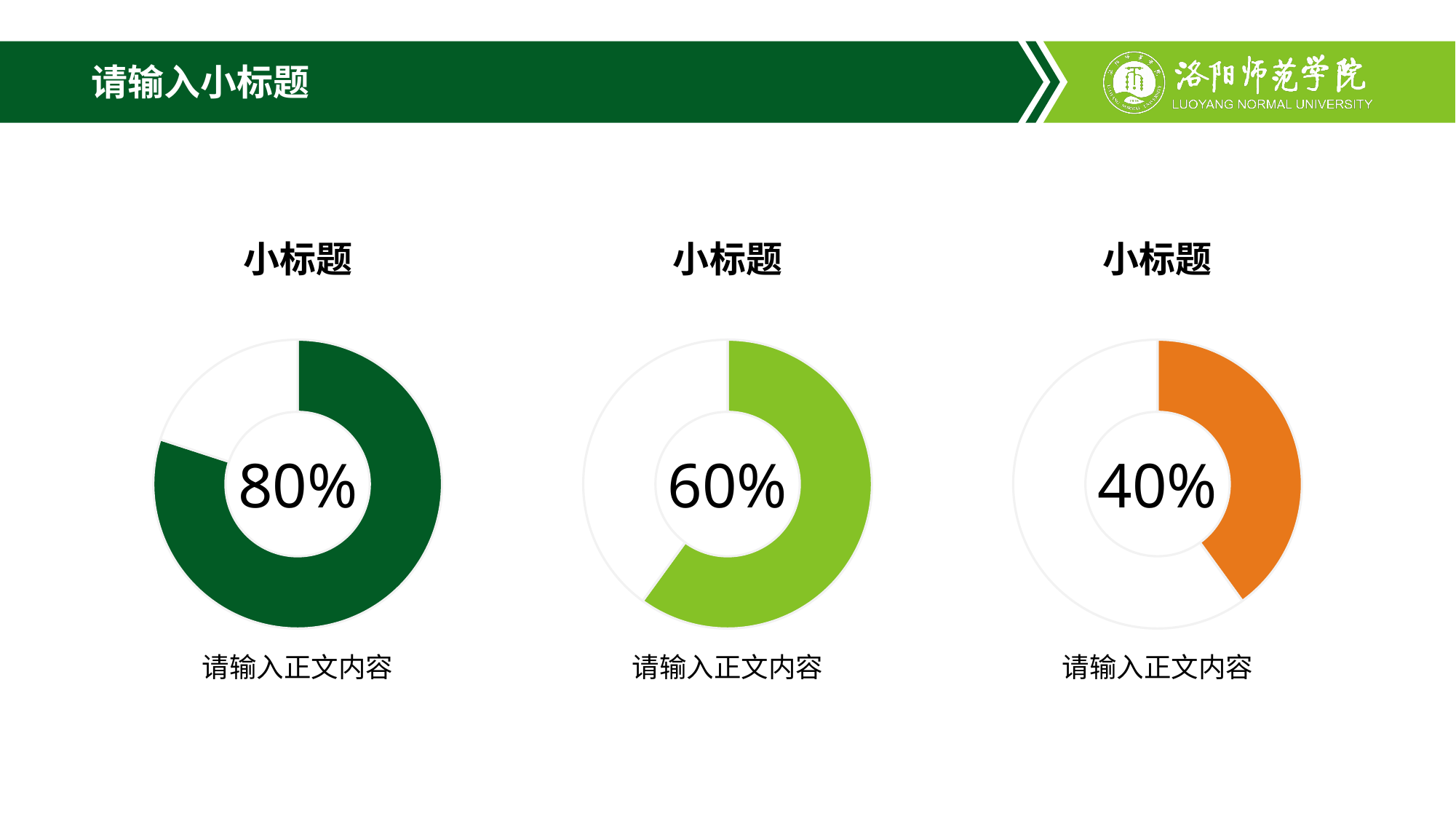
What is the difference between the percentage in the left doughnut chart and the percentage in the right doughnut chart? 40% Which of the three doughnut charts on the slide shows the highest percentage? The left chart (80%) What value is shown in the centre of the right doughnut chart? 40% What colour is the filled portion of the right doughnut chart? Orange What is the difference between the percentage in the left doughnut chart and the percentage in the middle doughnut chart? 20% What value is shown in the centre of the left doughnut chart? 80% Which is larger, the percentage in the middle doughnut chart or the percentage in the right doughnut chart? The middle chart (60%) Do the percentages rise or fall when reading the three doughnut charts from left to right? Fall What value is shown in the centre of the middle doughnut chart? 60% How many doughnut charts are shown on the slide? 3 What kind of chart is used for each of the three figures on the slide? Doughnut chart Which of the three doughnut charts on the slide shows the lowest percentage? The right chart (40%)